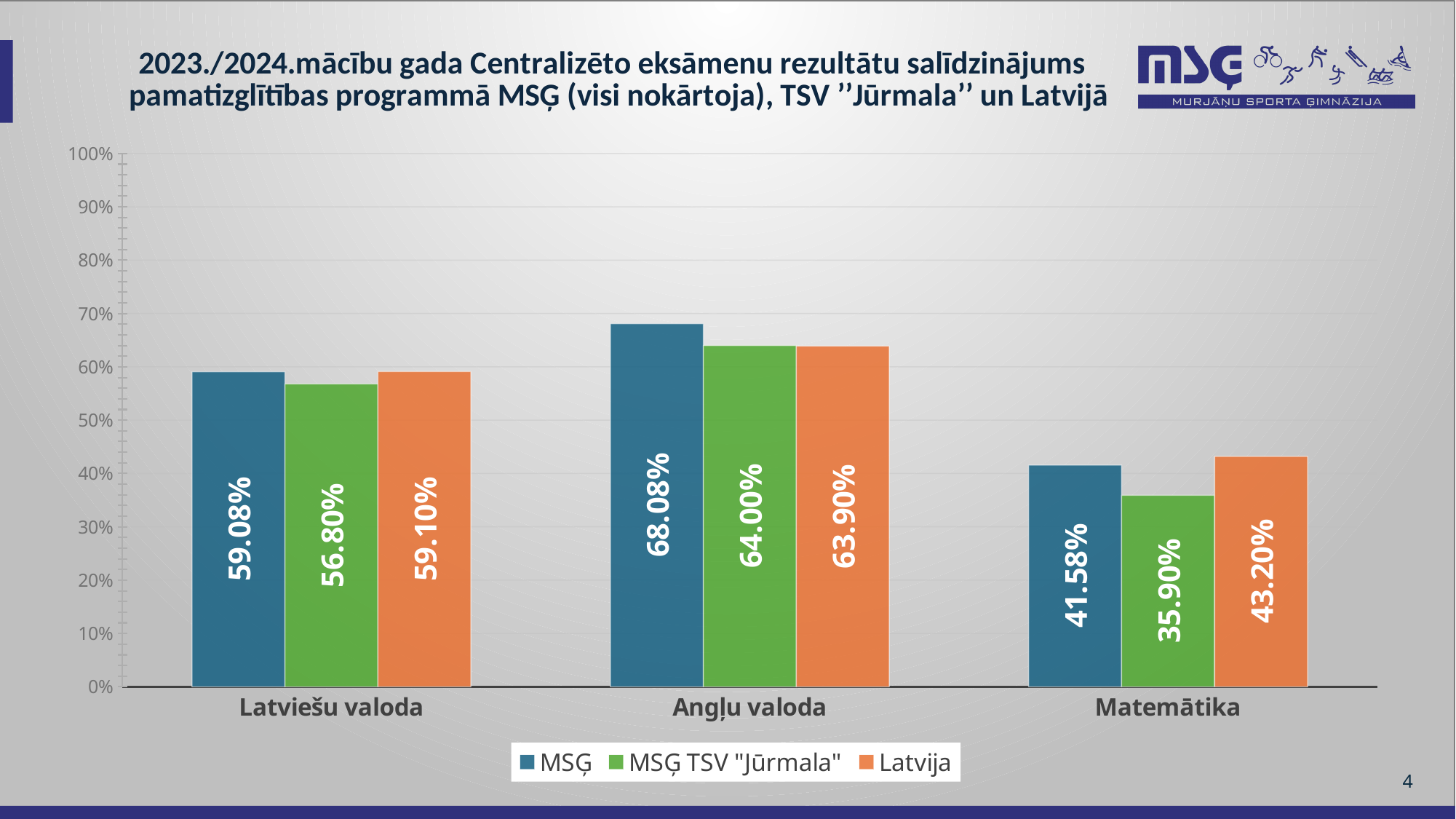
Which subject has the highest MSĢ value? Angļu valoda What is the MSĢ TSV "Jūrmala" value for Latviešu valoda? 56.80% Which colour represents the Latvija series in the chart? Orange What is the Latvija value for Matemātika? 43.20% For Matemātika, which is larger: the MSĢ value or the MSĢ TSV "Jūrmala" value? MSĢ How many subjects are shown on the x axis? 3 Is the Latvija value for Angļu valoda greater or less than 60%? greater How many series does the legend list? 3 What is the MSĢ value for Angļu valoda? 68.08% What kind of chart is shown on the slide? Bar chart What is the difference between the MSĢ and Latvija values for Angļu valoda? 4.18% Which subject has the lowest MSĢ TSV "Jūrmala" value? Matemātika